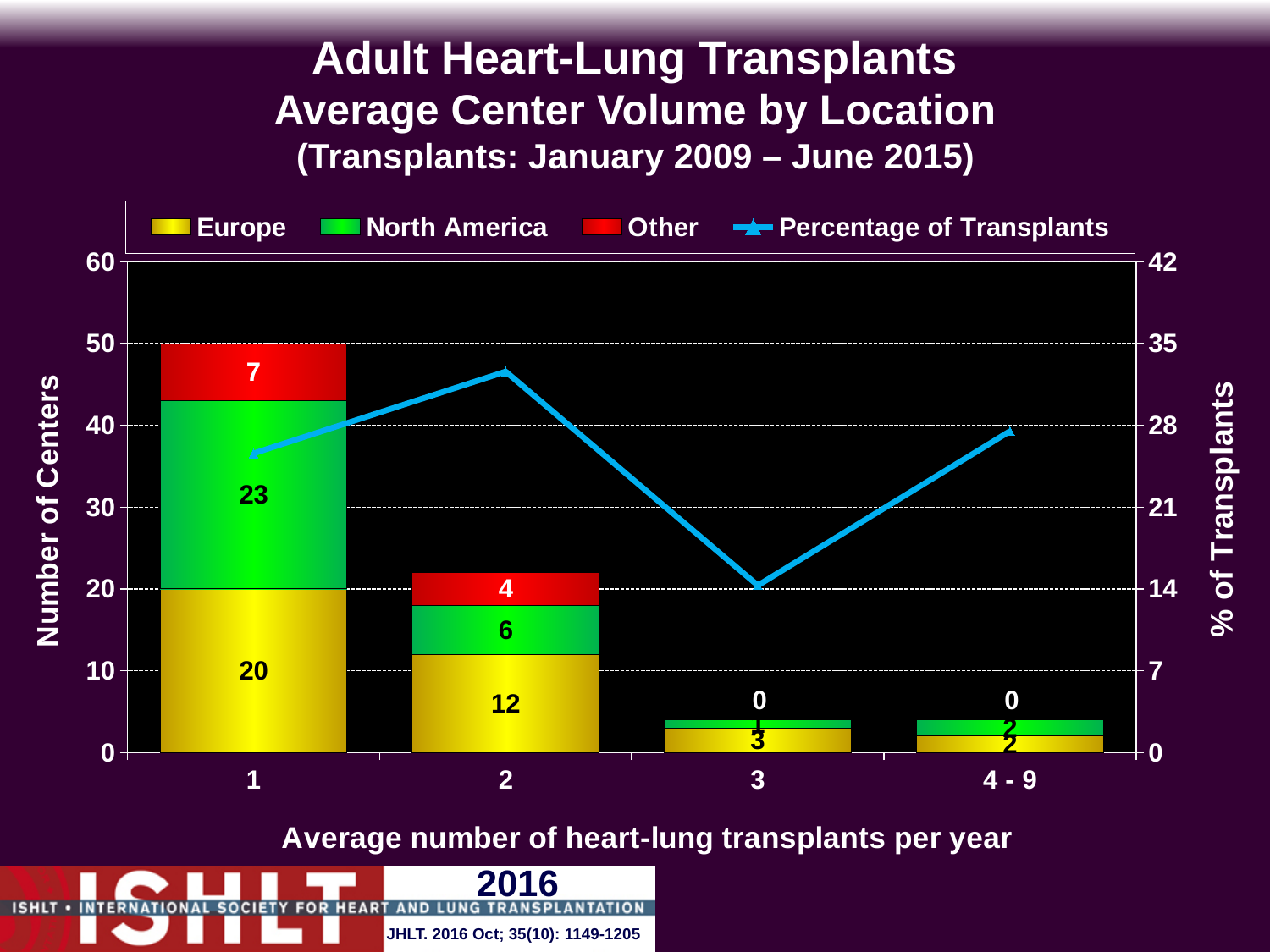
Is the Percentage of Transplants for the '2' category greater or less than 28? greater Which average-volume category has the highest total number of centers? 1 How many centers in Europe have an average of 1 heart-lung transplant per year? 20 How many categories are shown on the x axis? 4 How many series does the legend list? 4 In the '2' category, which has more centers: Europe or North America? Europe What is the value for 'Other' in the '3' transplants-per-year category? 0 What is the total number of centers in the '2' transplants-per-year category? 22 What is the total number of centers in the '1' transplants-per-year category (all locations combined)? 50 What is the number of North America centers in the '2' transplants-per-year category? 6 In the '1' category, how many more North America centers are there than Europe centers? 3 What is the title of the x axis? Average number of heart-lung transplants per year